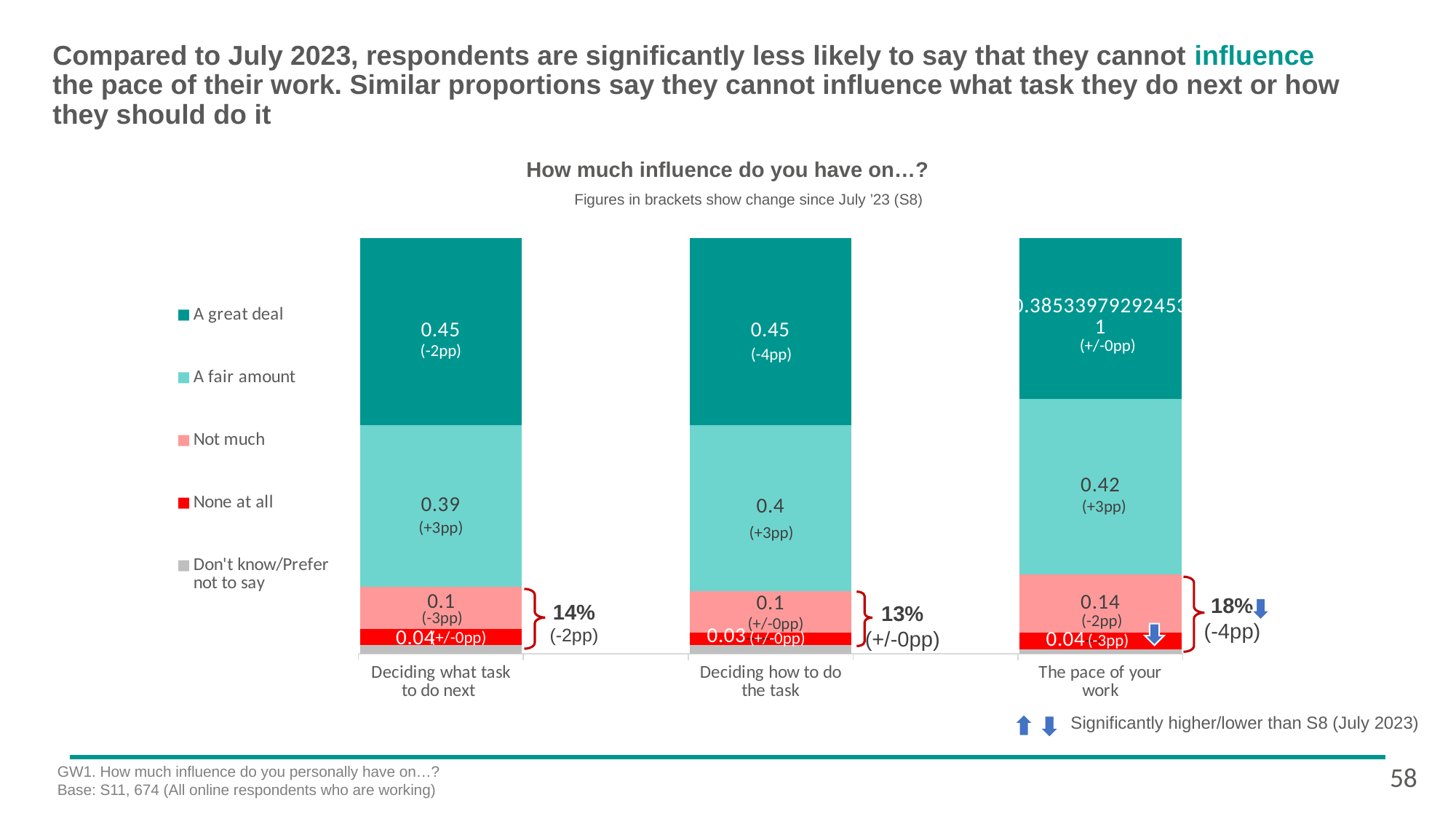
How many categories are shown on the x axis? 3 How many series does the legend list? 5 What is the value for 'A fair amount' for 'Deciding how to do the task'? 0.4 What is the value for 'None at all' for 'Deciding how to do the task'? 0.03 Which is larger: the 'Not much' value for 'The pace of your work' or for 'Deciding what task to do next'? The pace of your work What is the value for 'A great deal' for 'Deciding what task to do next'? 0.45 What combined percentage is shown by the bracket for 'The pace of your work'? 18% What is the value for 'Not much' for 'The pace of your work'? 0.14 Which category has the highest value for 'A fair amount'? The pace of your work What kind of chart is shown on the slide? Stacked bar chart Which category has the lowest value for 'None at all'? Deciding how to do the task What is the difference between the 'A fair amount' values for 'The pace of your work' and 'Deciding what task to do next'? 0.03